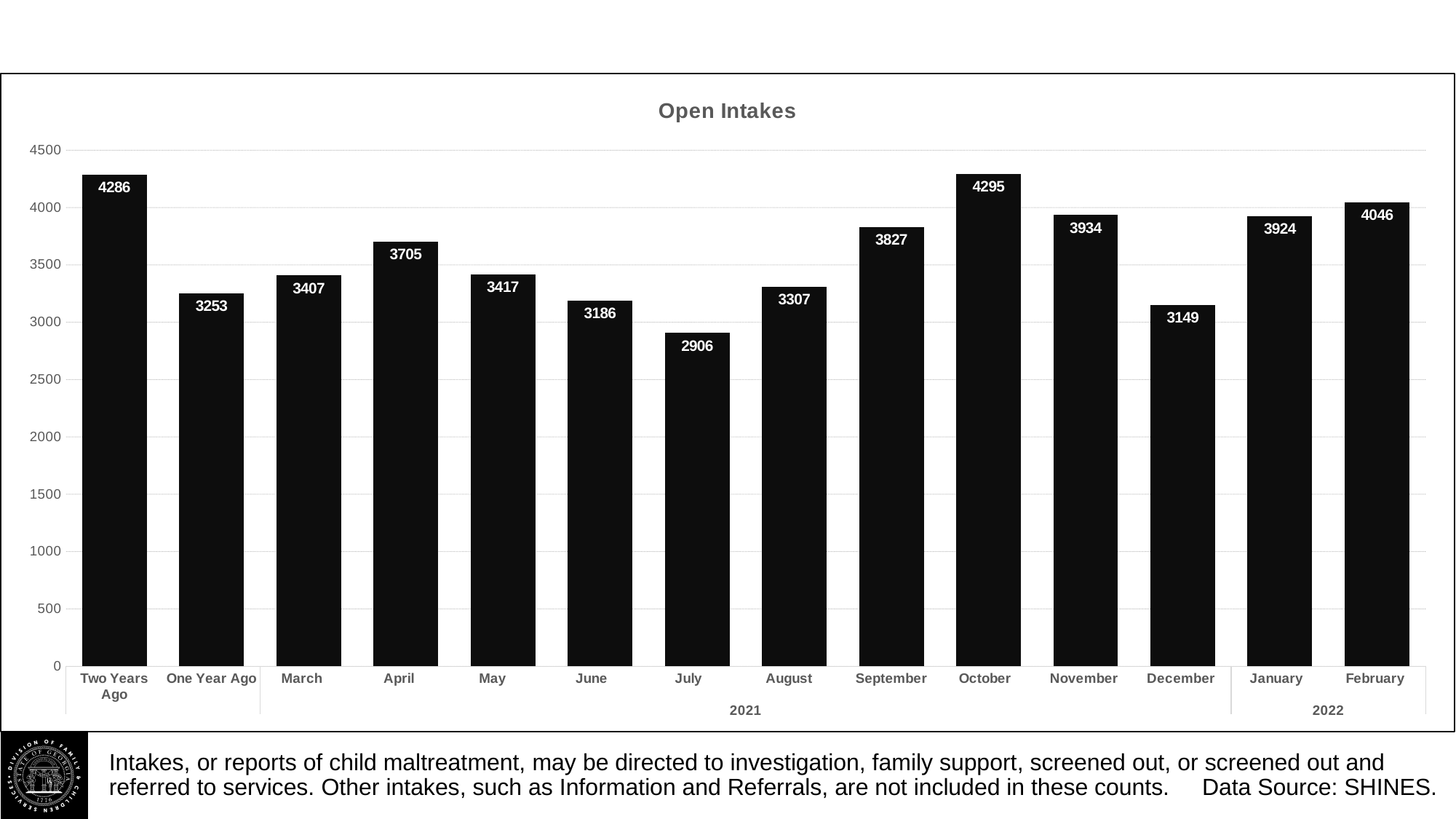
Which category has the highest value in the Open Intakes chart? October Which is larger, the value for April 2021 or the value for May 2021? April How many bars are shown in the Open Intakes chart? 14 What is the title of the chart? Open Intakes What is the value for February 2022 in the Open Intakes chart? 4046 What kind of chart is shown on the slide? Bar chart Which category has the lowest value in the Open Intakes chart? July What is the difference between the values for October 2021 and July 2021? 1389 What is the difference between the values for February 2022 and January 2022? 122 What is the value for July 2021 in the Open Intakes chart? 2906 What is the value for Two Years Ago in the Open Intakes chart? 4286 What is the value for October 2021 in the Open Intakes chart? 4295